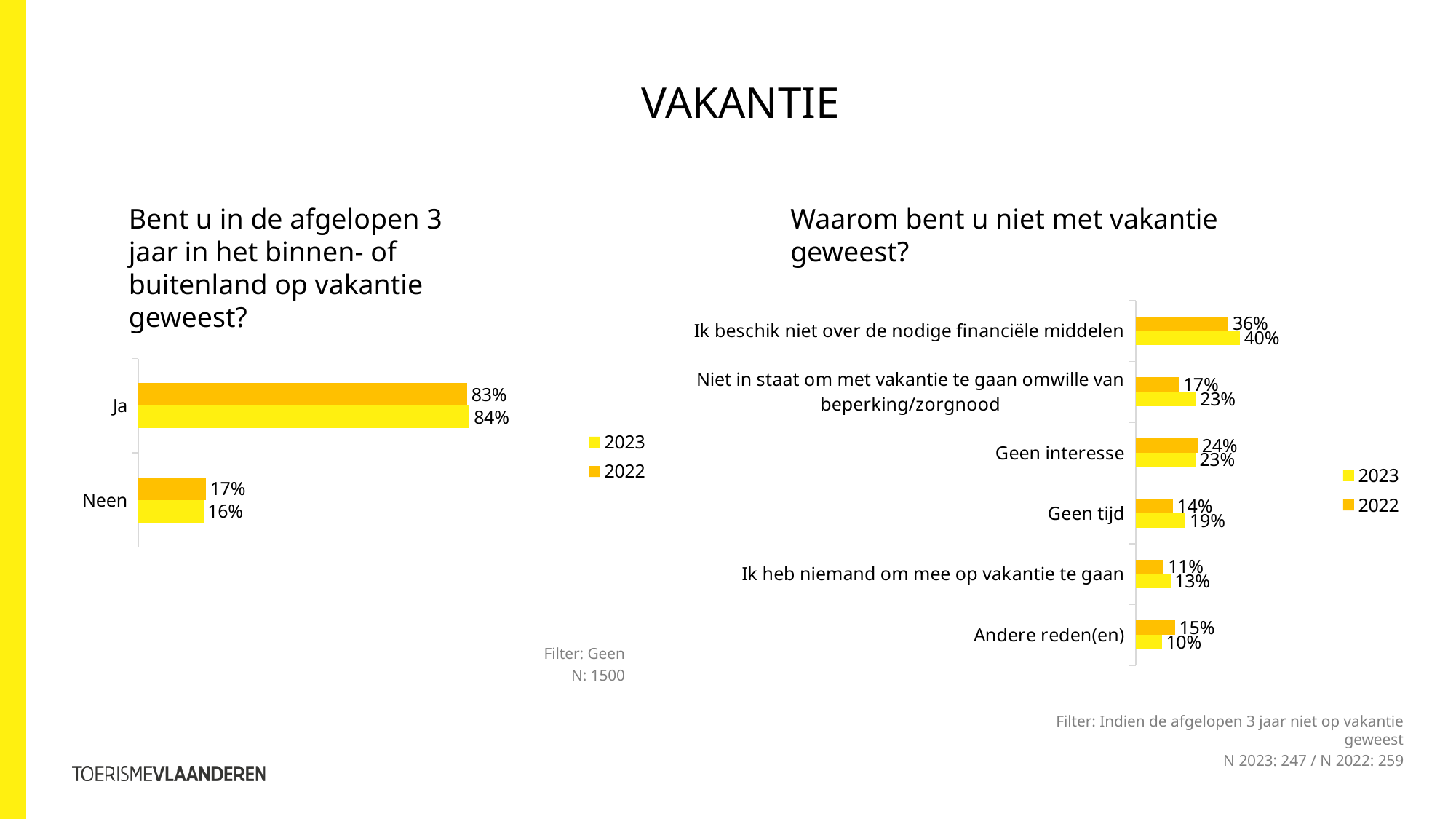
In the left chart ("Bent u in de afgelopen 3 jaar in het binnen- of buitenland op vakantie geweest?"), what is the 2022 value for "Neen"? 17% What kind of chart is the right chart ("Waarom bent u niet met vakantie geweest?")? Bar chart In the right chart ("Waarom bent u niet met vakantie geweest?"), what is the 2022 value for "Geen tijd"? 14% In the right chart ("Waarom bent u niet met vakantie geweest?"), which category has the highest 2023 value? Ik beschik niet over de nodige financiële middelen In the right chart ("Waarom bent u niet met vakantie geweest?"), which category has the lowest 2023 value? Andere reden(en) In the right chart ("Waarom bent u niet met vakantie geweest?"), how many categories are shown? 6 In the right chart ("Waarom bent u niet met vakantie geweest?"), which is larger for "Andere reden(en)": the 2022 value or the 2023 value? 2022 In the right chart ("Waarom bent u niet met vakantie geweest?"), what is the difference between the 2023 and 2022 values for "Niet in staat om met vakantie te gaan omwille van beperking/zorgnood"? 6% In the right chart ("Waarom bent u niet met vakantie geweest?"), what is the 2023 value for "Ik beschik niet over de nodige financiële middelen"? 40% In the left chart ("Bent u in de afgelopen 3 jaar in het binnen- of buitenland op vakantie geweest?"), what is the 2023 value for "Ja"? 84% In the left chart ("Bent u in de afgelopen 3 jaar in het binnen- of buitenland op vakantie geweest?"), what is the difference between the 2023 values for "Ja" and "Neen"? 68% In the left chart ("Bent u in de afgelopen 3 jaar in het binnen- of buitenland op vakantie geweest?"), how many series does the legend list? 2